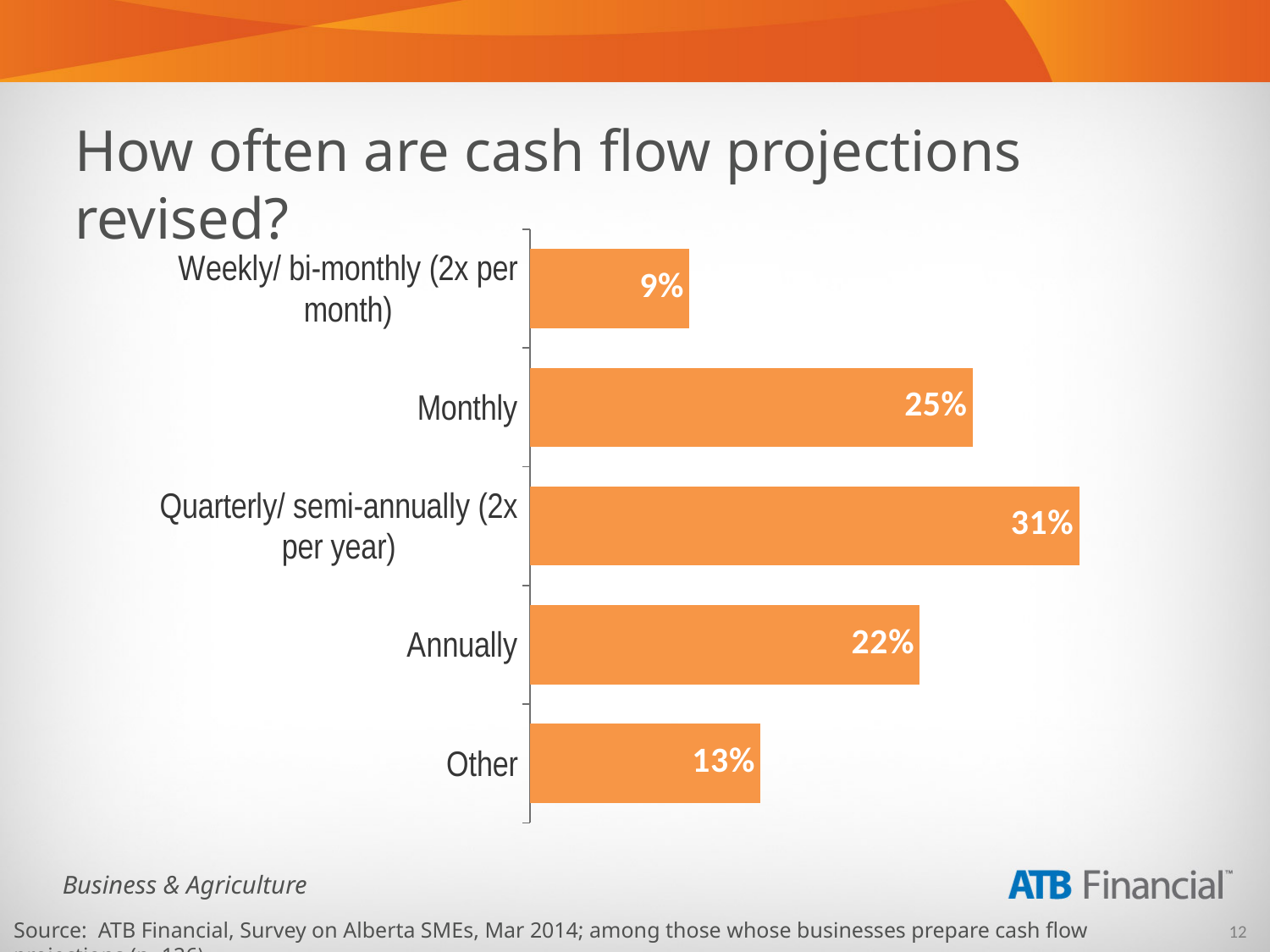
What is the difference between the values for 'Other' and 'Weekly/ bi-monthly (2x per month)'? 4% Which category has the lowest value? Weekly/ bi-monthly (2x per month) What is the value for 'Other'? 13% What is the difference between the values for 'Quarterly/ semi-annually (2x per year)' and 'Annually'? 9% Which category has the highest value? Quarterly/ semi-annually (2x per year) What is the value for 'Weekly/ bi-monthly (2x per month)'? 9% What is the title of the slide containing the chart? How often are cash flow projections revised? Which is larger, the value for 'Monthly' or the value for 'Annually'? Monthly What is the value for 'Quarterly/ semi-annually (2x per year)'? 31% What kind of chart is shown on the slide? Bar chart What percentage of respondents revise cash flow projections monthly? 25% How many categories are shown in the chart? 5